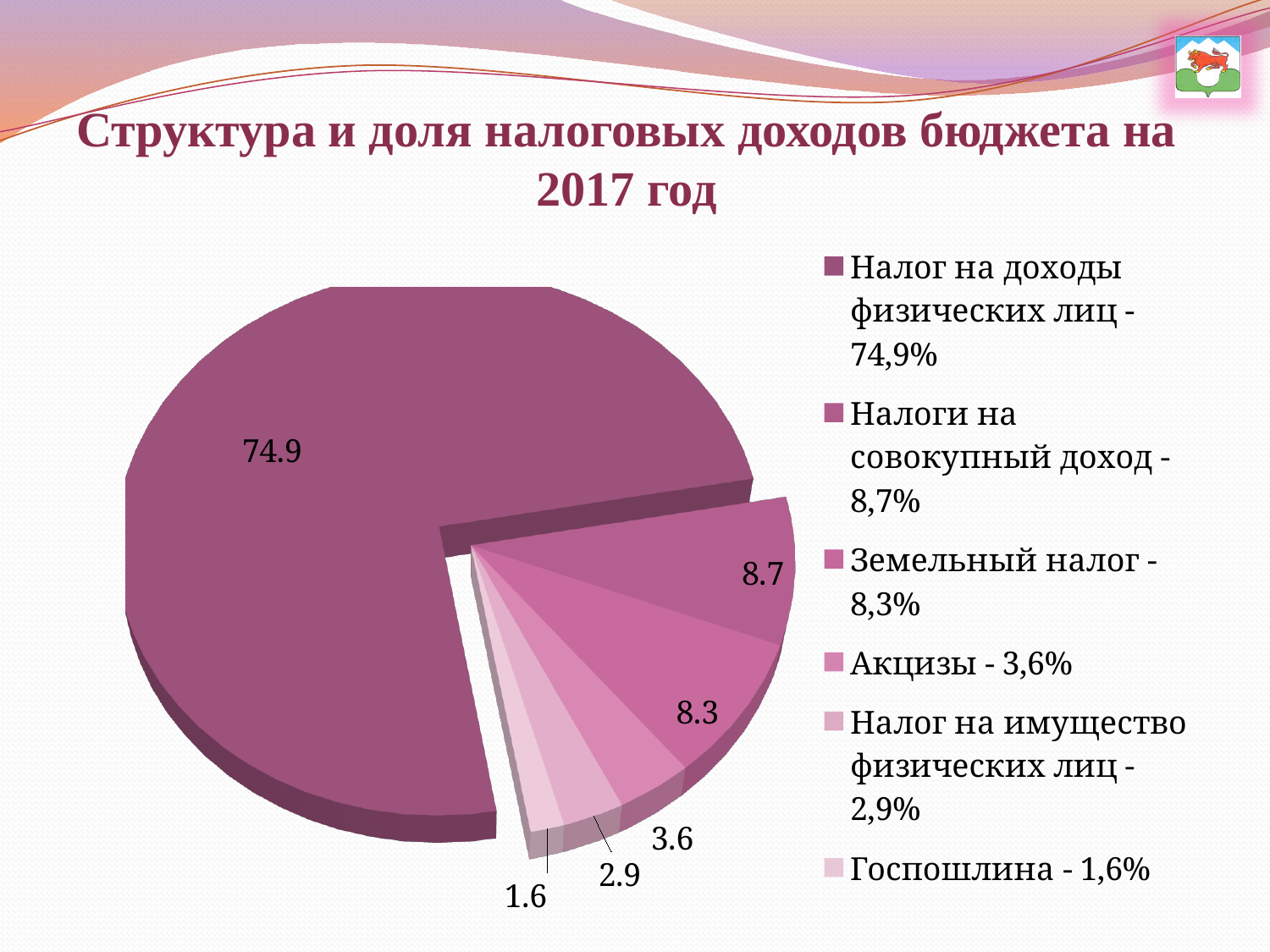
What is the difference between the values for Налоги на совокупный доход and Земельный налог? 0.4 Which category has the largest slice of the pie? Налог на доходы физических лиц What is the value shown for Налог на доходы физических лиц? 74.9 What is the title of the slide? Структура и доля налоговых доходов бюджета на 2017 год How many categories does the pie chart have? 6 Which is larger: the value for Акцизы or the value for Налог на имущество физических лиц? Акцизы What is the value shown for Акцизы? 3.6 Which category has the smallest slice of the pie? Госпошлина What is the value shown for Земельный налог? 8.3 What type of chart is shown on the slide? pie chart What is the value shown for Налоги на совокупный доход? 8.7 What is the value shown for Госпошлина? 1.6